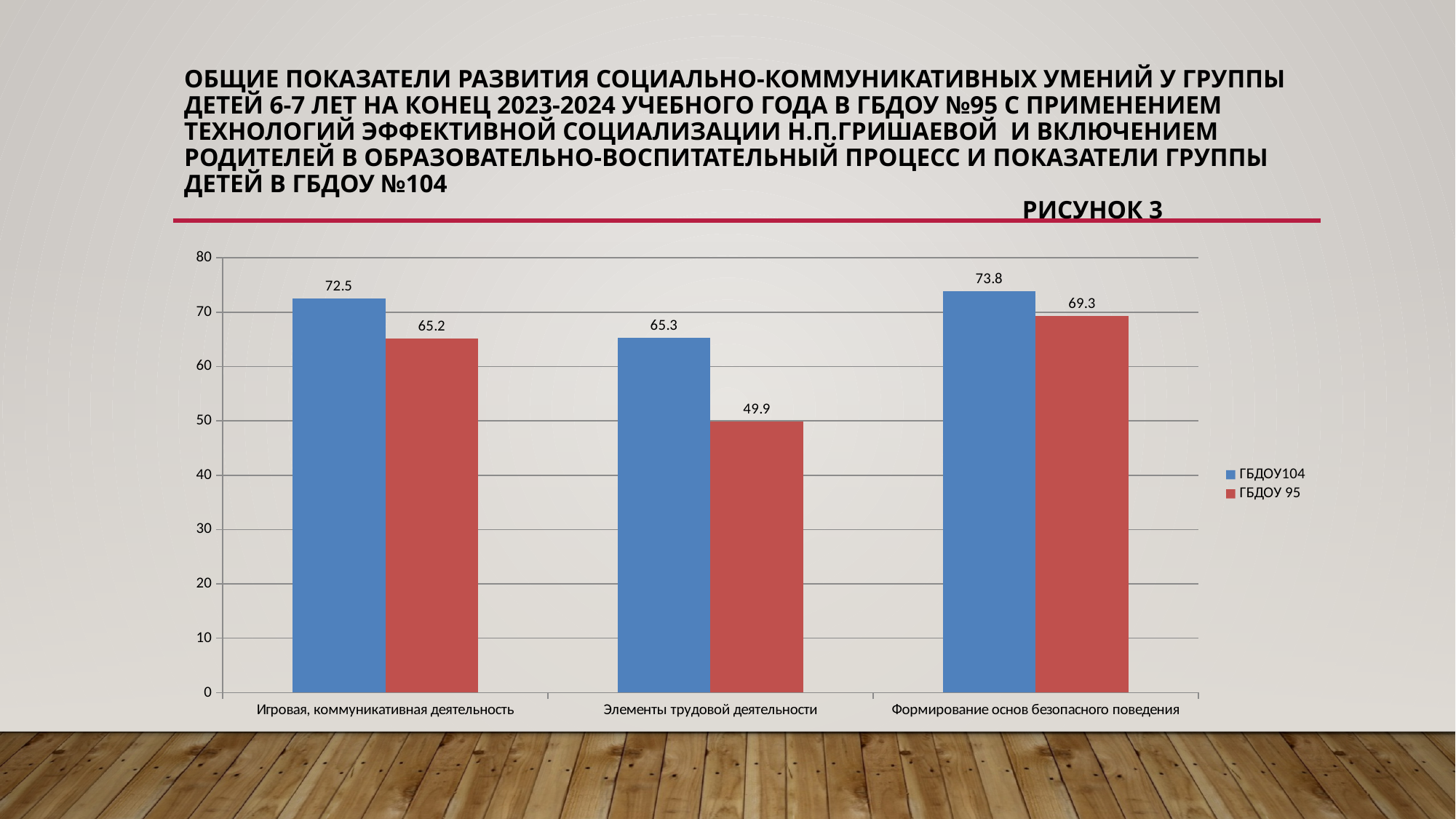
In which category does ГБДОУ 95 have its lowest value? Элементы трудовой деятельности What is the value for ГБДОУ 95 in the category Формирование основ безопасного поведения? 69.3 What kind of chart is shown on the slide? bar chart Which colour represents ГБДОУ 95 in the chart? red Is the value for ГБДОУ 95 in the category Элементы трудовой деятельности greater or less than 60? less What is the value for ГБДОУ104 in the category Игровая, коммуникативная деятельность? 72.5 How many categories are shown on the x axis? 3 How many series does the legend list? 2 What is the difference between ГБДОУ104 and ГБДОУ 95 in the category Элементы трудовой деятельности? 15.4 What is the value for ГБДОУ 95 in the category Элементы трудовой деятельности? 49.9 Which series has the larger value in the category Игровая, коммуникативная деятельность, ГБДОУ104 or ГБДОУ 95? ГБДОУ104 In which category does ГБДОУ104 have its highest value? Формирование основ безопасного поведения